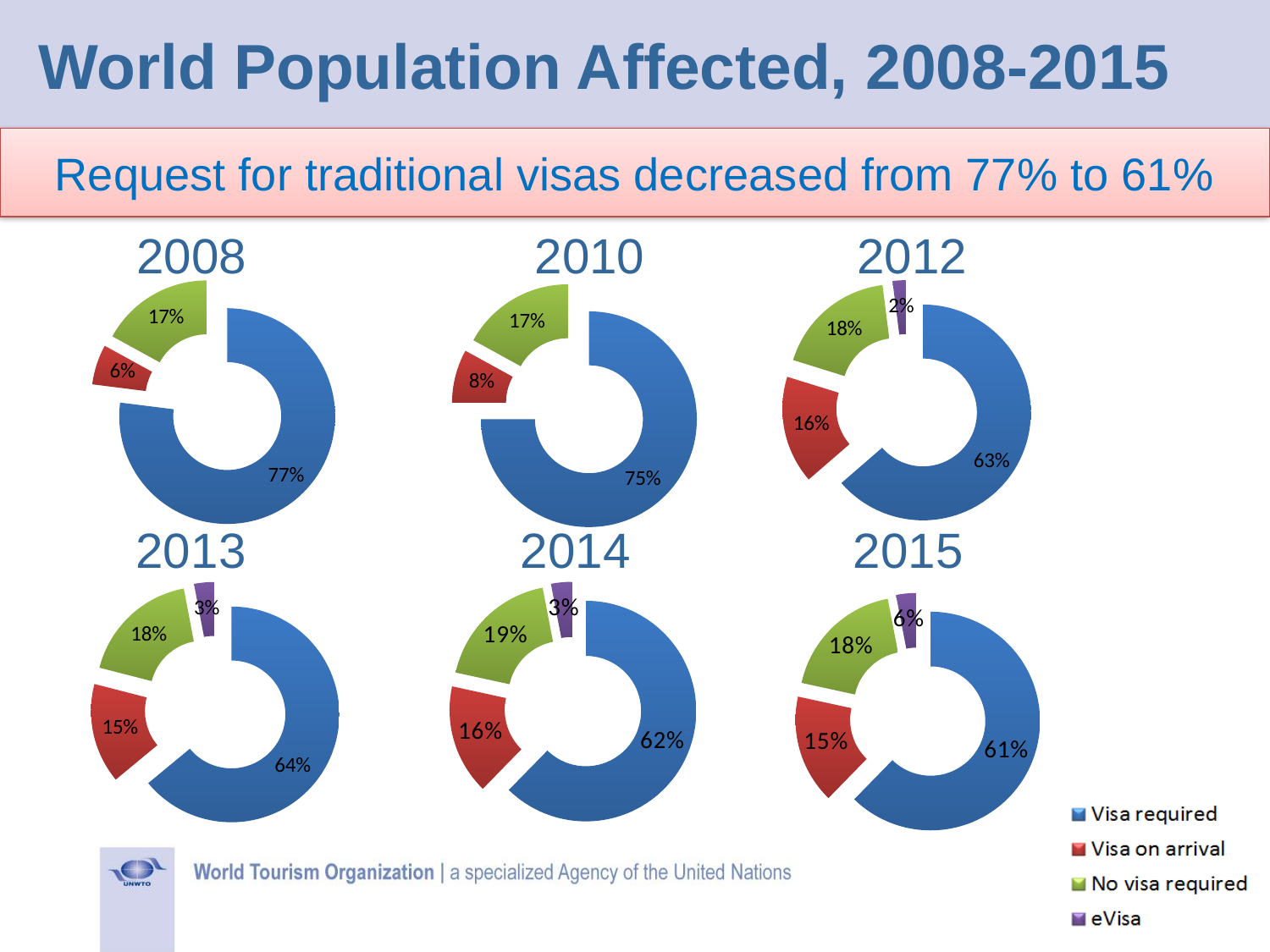
How many series does the legend list? 4 What kind of chart is used for each year on the slide? Pie (doughnut) chart In the 2008 chart, what is the difference between the Visa required share and the No visa required share? 60% In the 2013 chart, which category has the smallest share? eVisa In the 2012 chart, which is larger: the share for No visa required or the share for Visa on arrival? No visa required How many slices does the 2008 chart have? 3 In the 2010 chart, which category has the largest share? Visa required Across the charts from 2008 to 2015, does the Visa required share rise or fall? Fall In the 2014 chart, what share is labelled for No visa required? 19% In the 2015 chart, what share is labelled for eVisa? 6% In the 2012 chart, what share is labelled for Visa on arrival? 16% In the 2008 chart, what share is labelled for Visa required? 77%